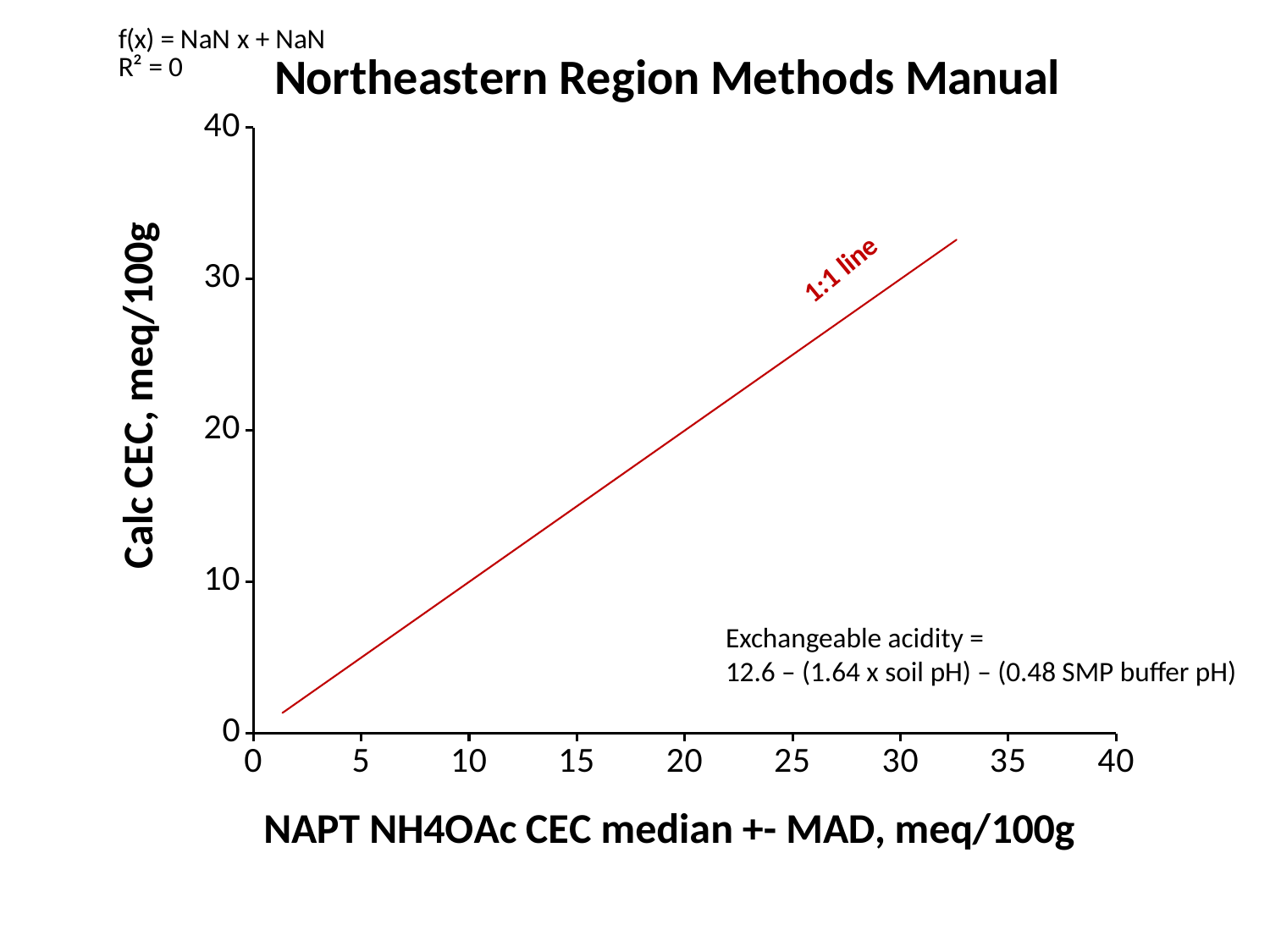
Does the red 1:1 line rise or fall as the x-axis value increases? rise What is the title of the chart? Northeastern Region Methods Manual What kind of chart is shown on the slide? scatter chart What label is written along the red diagonal line? 1:1 line